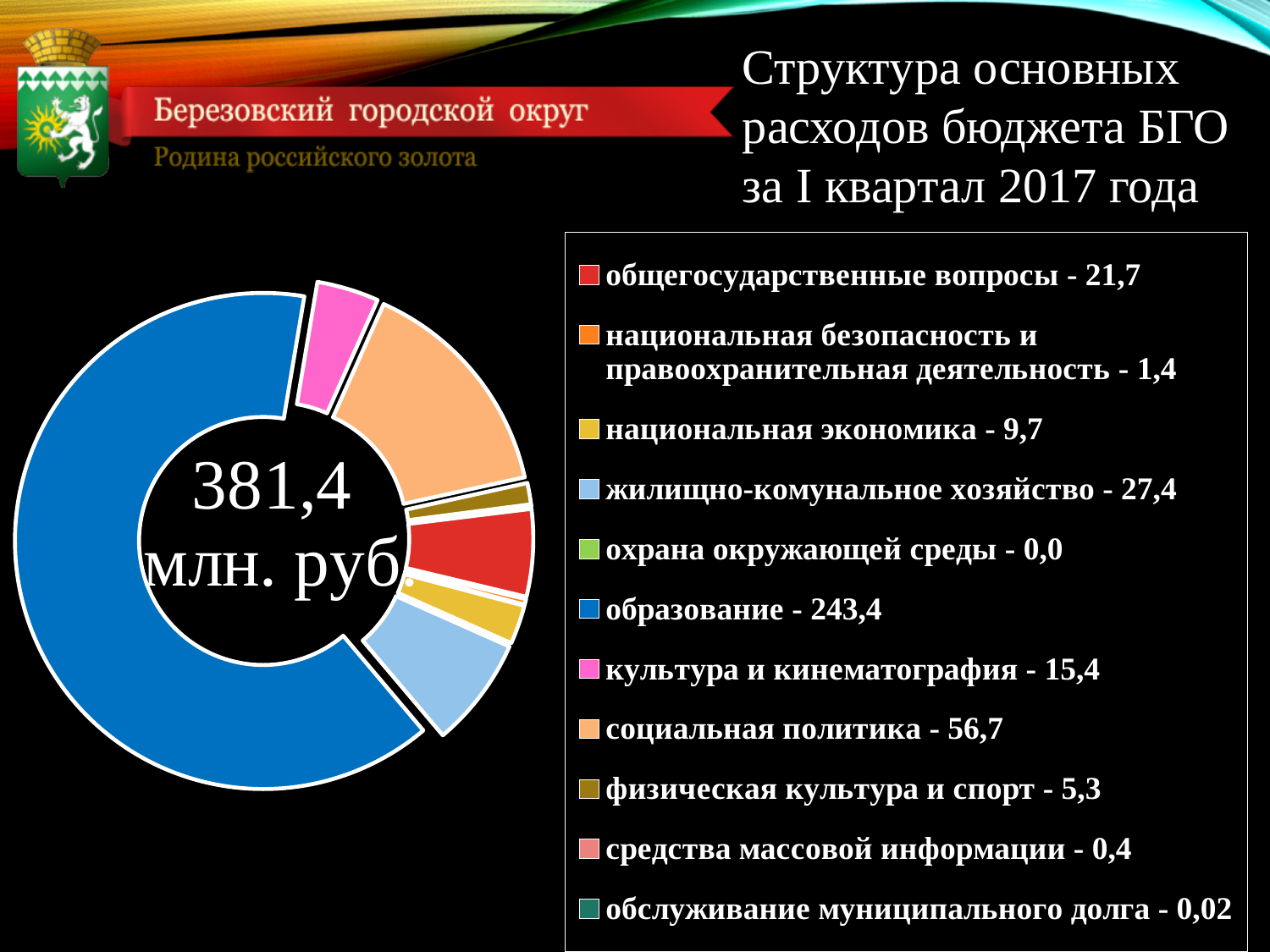
How many categories does the legend list? 11 Which category has the lowest value? охрана окружающей среды What total value is shown in the centre of the chart? 381,4 млн. руб. What is the difference between образование and социальная политика? 186,7 What is the value for обслуживание муниципального долга? 0,02 What is the value for жилищно-комунальное хозяйство? 27,4 Which is larger: общегосударственные вопросы or жилищно-комунальное хозяйство? жилищно-комунальное хозяйство What is the title of the chart? Структура основных расходов бюджета БГО за I квартал 2017 года What is the value for социальная политика? 56,7 What is the value for образование? 243,4 What kind of chart is shown on the slide? doughnut (pie) chart Which category has the highest value? образование